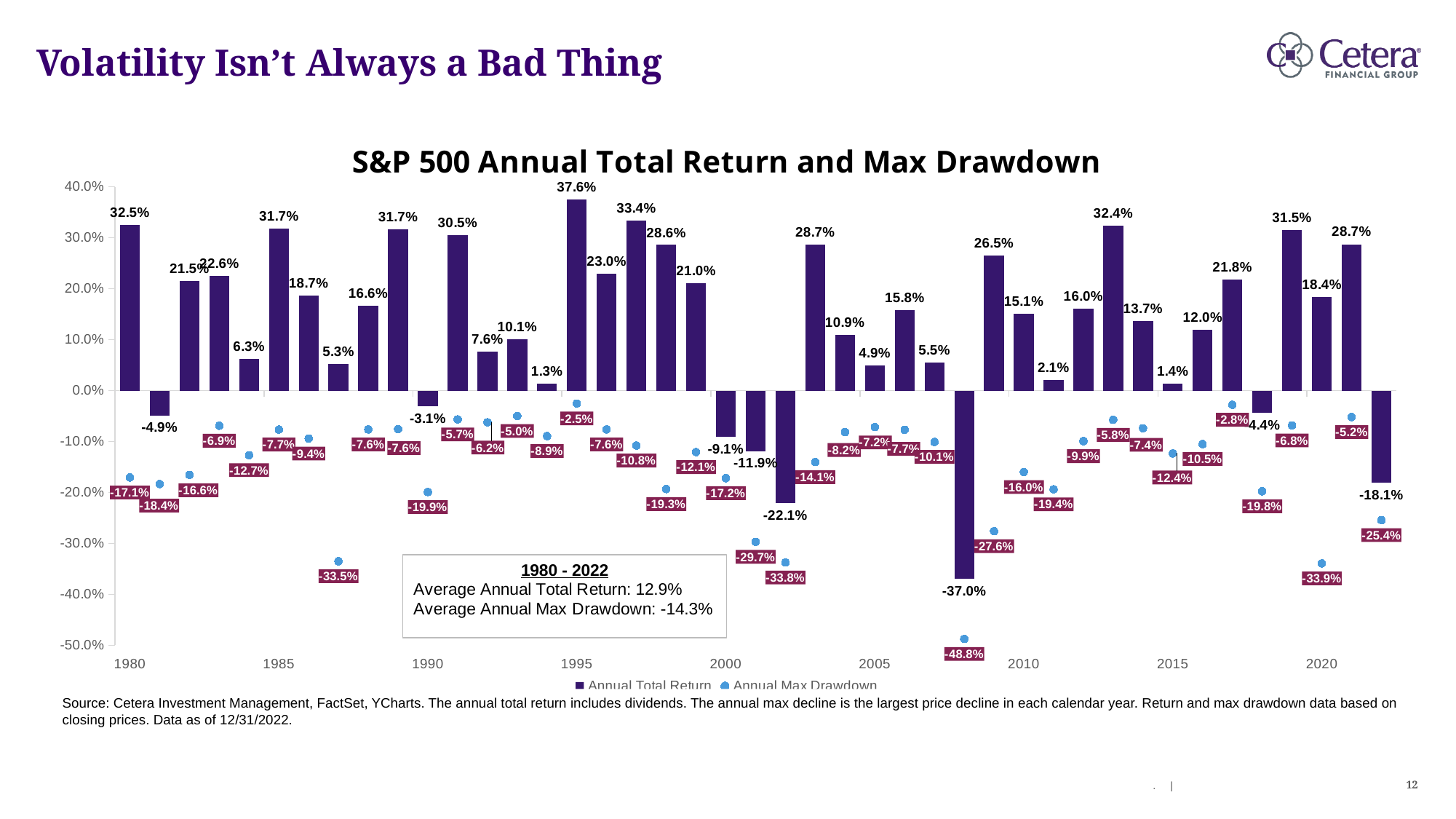
How many series does the legend list? 2 What is the average annual total return for 1980-2022 shown in the text box? 12.9% What was the annual max drawdown in 2008? -48.8% What was the annual total return for 2022? -18.1% Which year had a larger annual total return, 2003 or 2009? 2003 What kind of chart is shown on the slide? Bar chart (with drawdown points) What was the annual total return for 1995? 37.6% Which year had the highest annual total return? 1995 What is the title of the chart? S&P 500 Annual Total Return and Max Drawdown What is the difference between the annual total return in 2013 (32.4%) and in 2014 (13.7%)? 18.7 percentage points Which year had the lowest annual total return? 2008 What was the annual max drawdown in 2020? -33.9%